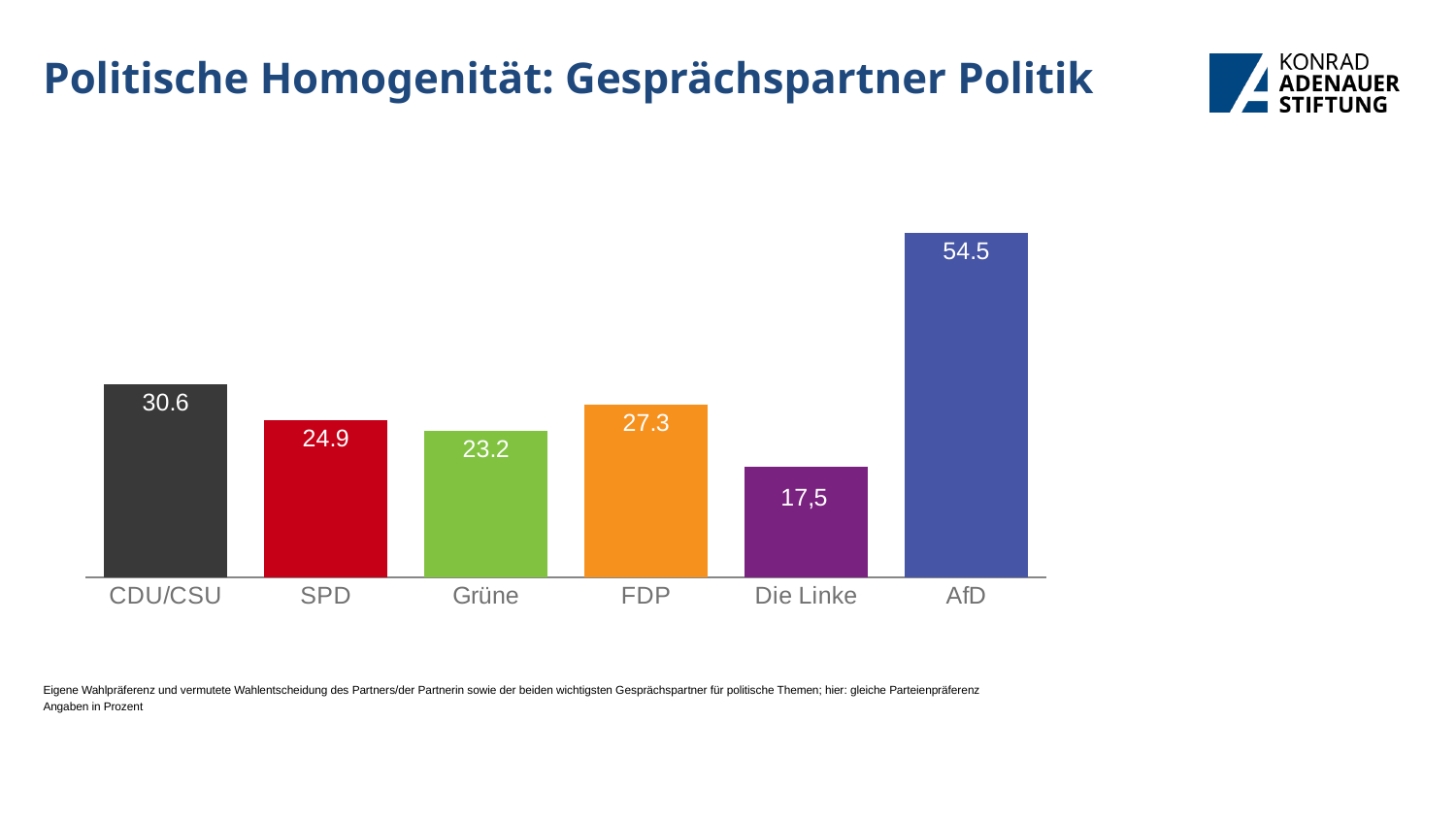
Which party has the highest value? AfD What is the value for Die Linke? 17,5 What is the value for AfD? 54.5 What is the difference between the values for AfD and CDU/CSU? 23.9 What colour is the bar for Grüne? Green What is the value for CDU/CSU? 30.6 What is the difference between the values for SPD and Grüne? 1.7 How many parties are shown in the chart? 6 What kind of chart is shown on the slide? Bar chart What is the value for FDP? 27.3 Which party has the lowest value? Die Linke Which is larger, the value for FDP or the value for SPD? FDP